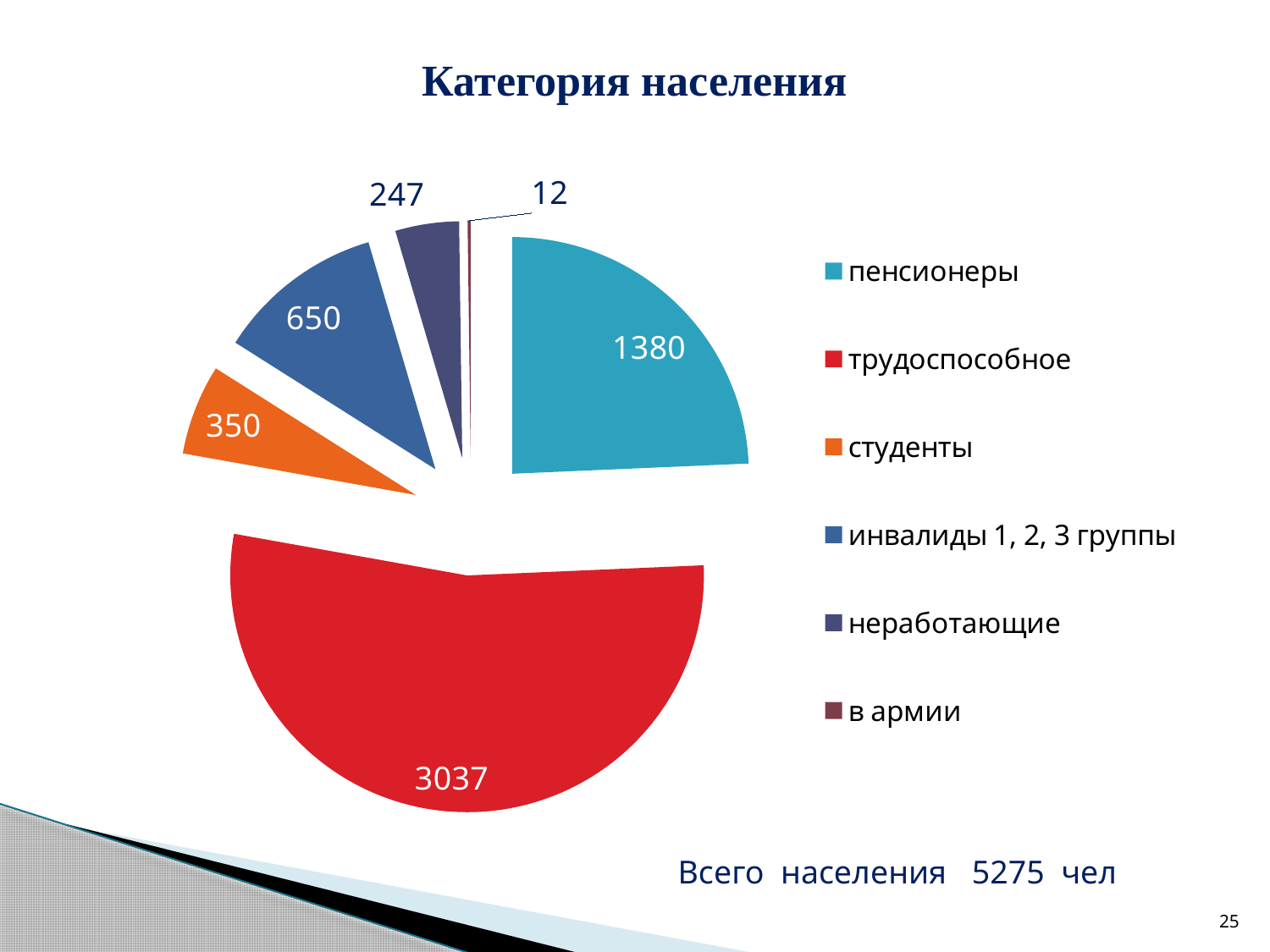
What is the value for студенты? 350 Which category has the smallest slice of the pie? в армии What is the value for инвалиды 1, 2, 3 группы? 650 What is the difference between the values for трудоспособное and пенсионеры? 1657 What is the value for трудоспособное? 3037 What is the title of the chart? Категория населения What is the value for неработающие? 247 Which is larger, the value for инвалиды 1, 2, 3 группы or the value for студенты? инвалиды 1, 2, 3 группы How many categories does the legend list? 6 Which category has the largest slice of the pie? трудоспособное What type of chart is shown on the slide? pie chart What is the value for пенсионеры? 1380